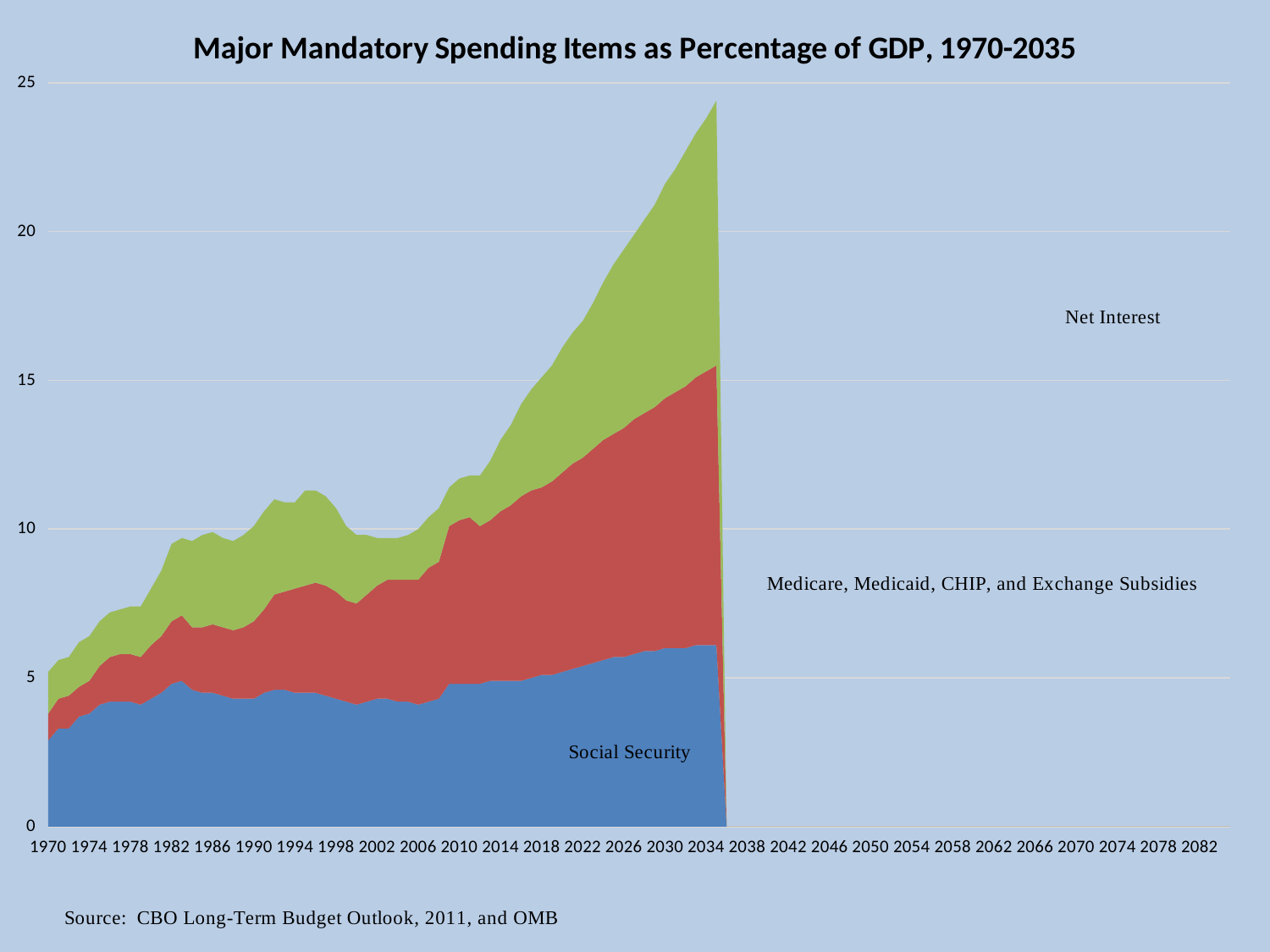
Does the total stacked value rise or fall between 2010 and 2034? rise Is the total of all three series in 1970 greater or less than 10? less Is the combined value of Social Security and Medicare, Medicaid, CHIP, and Exchange Subsidies in 2034 greater or less than 10? greater What is the highest value shown on the vertical axis? 25 What is the title of the chart? Major Mandatory Spending Items as Percentage of GDP, 1970-2035 Which series is larger in 2034: Social Security or Net Interest? Net Interest Which series forms the bottom layer of the stacked area? Social Security How many spending series are labeled on the chart? 3 What kind of chart is shown on the slide? Stacked area chart Is the Social Security value in 2034 greater or less than 5? greater